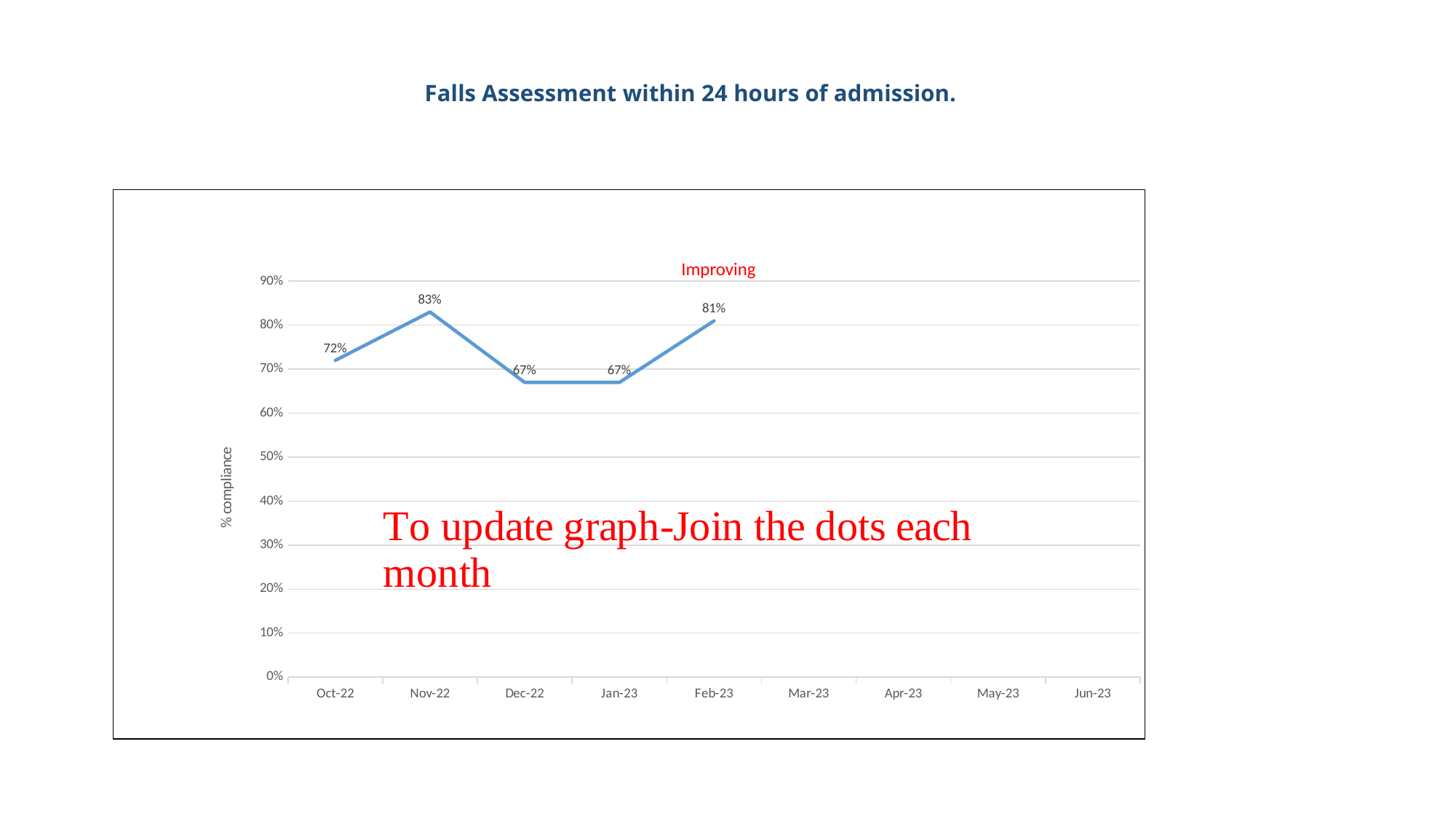
What is the % compliance value for Oct-22? 72% What is the difference between the Nov-22 and Dec-22 values? 16% What is the % compliance value for Nov-22? 83% Which month has the highest % compliance value? Nov-22 What is the label on the vertical axis of the chart? % compliance What is the % compliance value for Feb-23? 81% Which is larger, the value for Oct-22 or the value for Dec-22? Oct-22 What kind of chart is shown on the slide? line chart What is the difference between the Feb-23 and Jan-23 values? 14% Is the value for Jan-23 greater or less than 70%? less How many month categories are shown on the x axis? 9 How many months have a plotted data point on the chart? 5